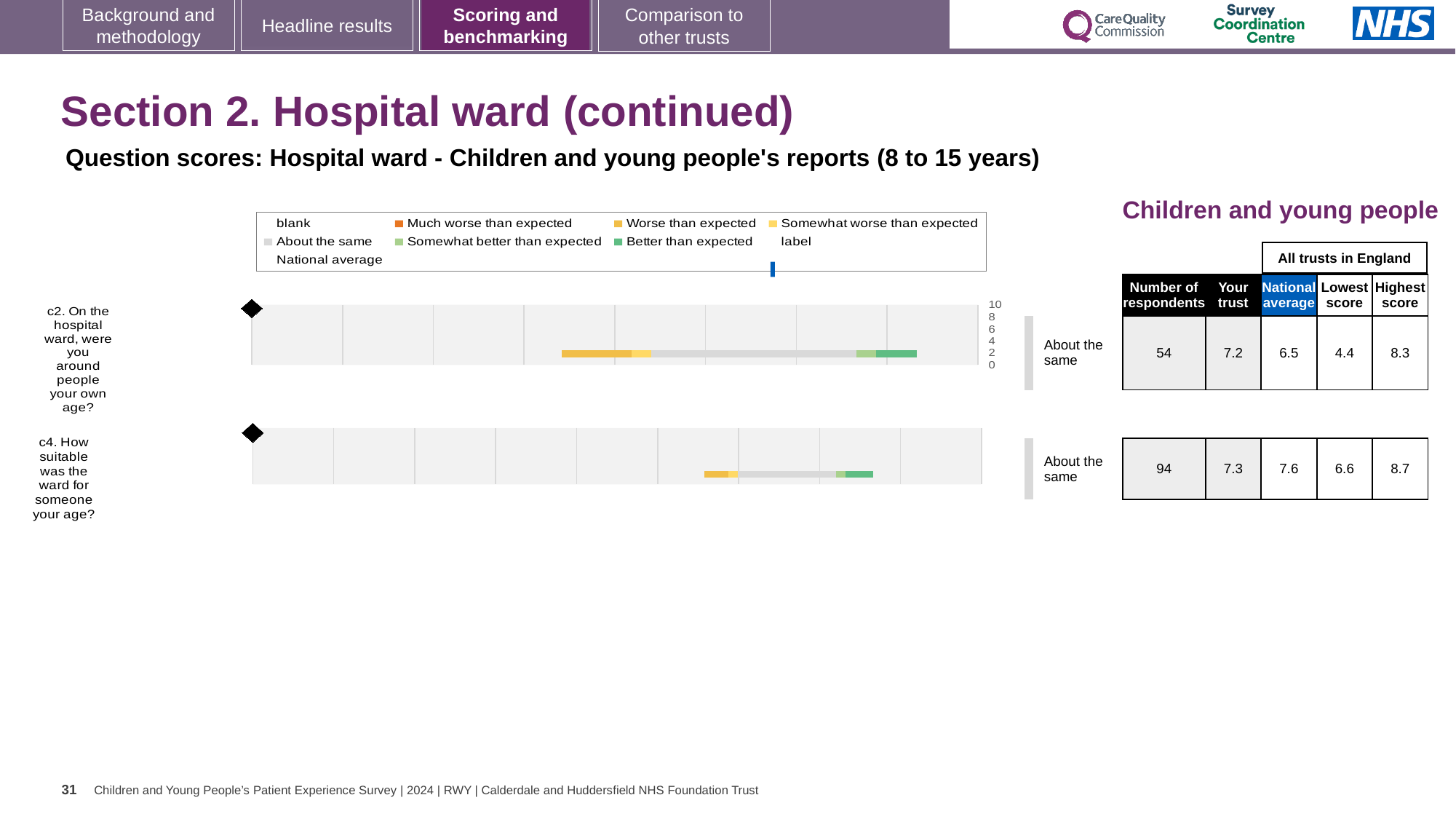
What is the highest score among all trusts in England for question c4? 8.7 For question c2, which is higher: the 'Your trust' score or the national average? Your trust What kind of chart is used to show the question scores? Bar chart For question c4, what is the difference between the highest score and the lowest score across all trusts in England? 2.1 What is the lowest score among all trusts in England for question c2? 4.4 For question c2, how much higher is the 'Your trust' score than the national average? 0.7 How many questions are plotted on the chart? 2 What is the 'Your trust' score for question c2 (On the hospital ward, were you around people your own age?)? 7.2 What is the national average score for question c4 (How suitable was the ward for someone your age?)? 7.6 Which question had more respondents, c2 or c4? c4 What benchmark category is shown for question c4? About the same How many respondents answered question c2? 54